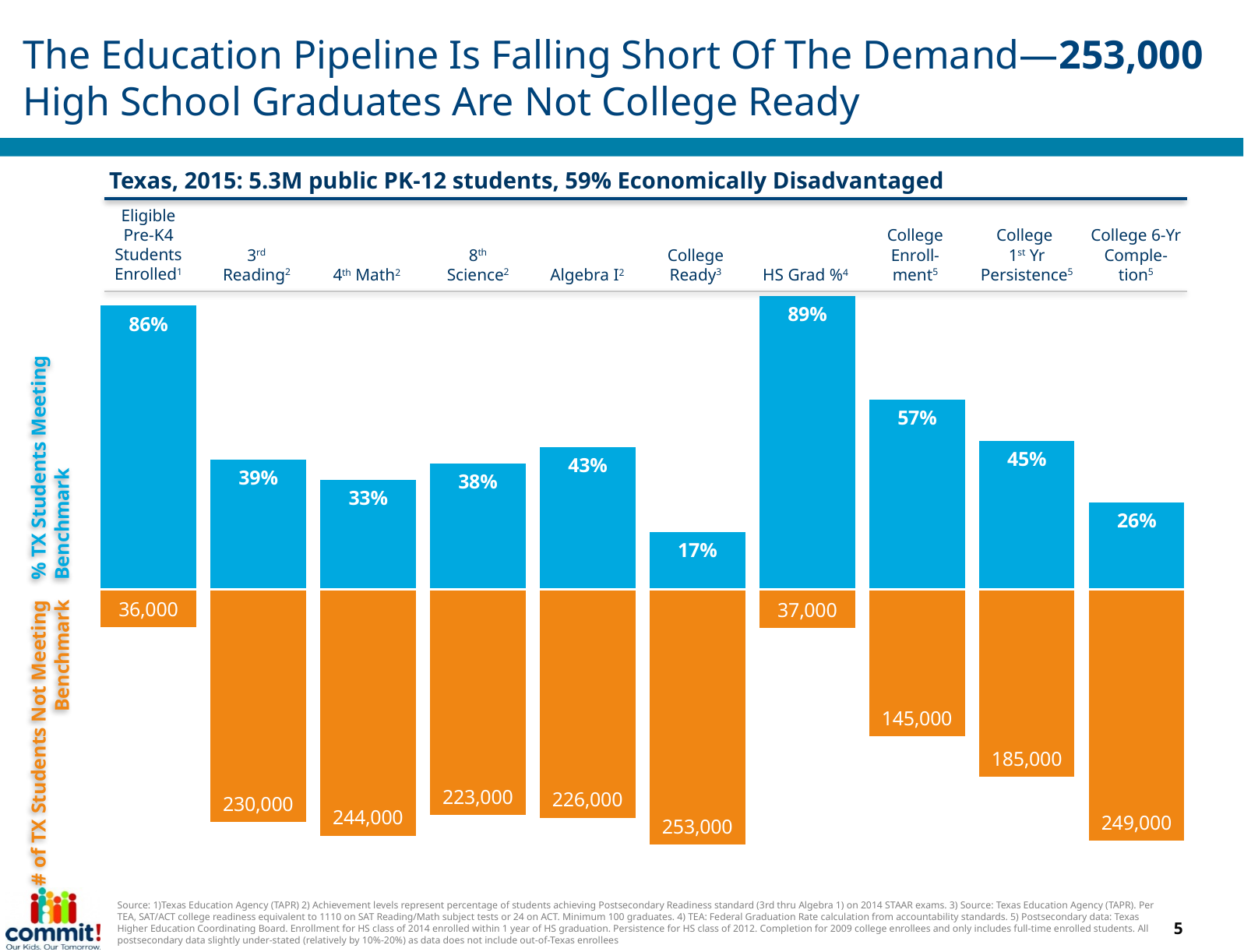
Which category has the lowest percentage of TX students meeting the benchmark? College Ready Which has a higher percentage of students meeting the benchmark, 3rd Reading or 8th Science? 3rd Reading Which category has the highest percentage of TX students meeting the benchmark? HS Grad % How many categories are shown along the top of the chart? 10 What kind of chart is shown on the slide? Bar chart What is the number of TX students not meeting the benchmark for College 6-Yr Completion? 249,000 What is the difference in percentage points between the College Enrollment benchmark (57%) and the College 1st Yr Persistence benchmark (45%)? 12 What does the orange portion of the chart represent, according to the left-hand axis label? # of TX Students Not Meeting Benchmark Which category has the smallest number of TX students not meeting the benchmark? Eligible Pre-K4 Students Enrolled Which category has the largest number of TX students not meeting the benchmark? College Ready What percentage of TX students meet the benchmark for College Ready? 17% How many TX students are not meeting the benchmark for 4th Math? 244,000